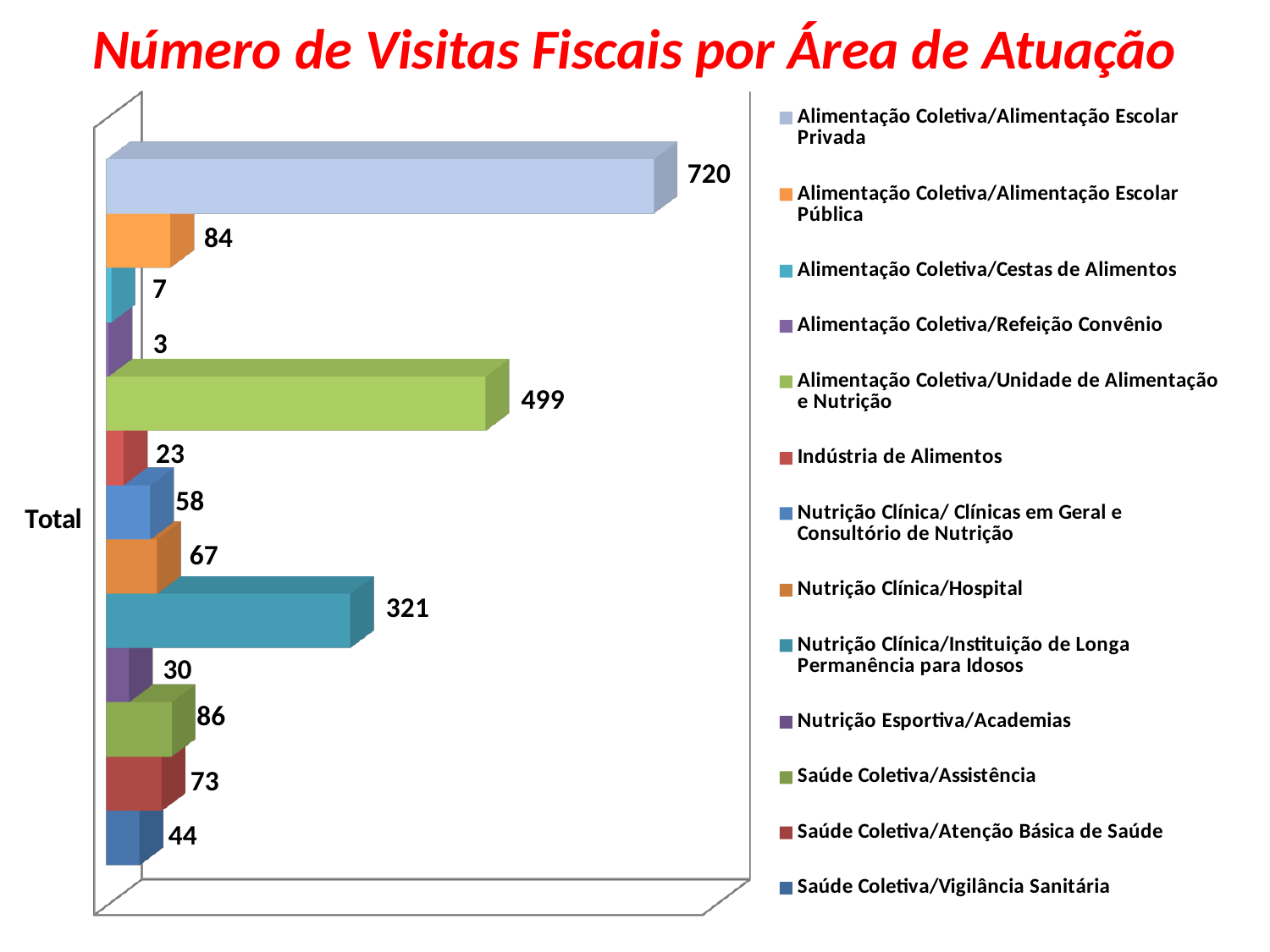
How many series does the legend list? 13 What is the difference between the values for Alimentação Coletiva/Alimentação Escolar Privada and Alimentação Coletiva/Unidade de Alimentação e Nutrição? 221 What is the value for Alimentação Coletiva/Unidade de Alimentação e Nutrição? 499 What is the value for Alimentação Coletiva/Alimentação Escolar Privada? 720 What is the value for Saúde Coletiva/Vigilância Sanitária? 44 Which is larger, the value for Saúde Coletiva/Assistência or the value for Saúde Coletiva/Atenção Básica de Saúde? Saúde Coletiva/Assistência Which series has the lowest value? Alimentação Coletiva/Refeição Convênio What kind of chart is shown on the slide? Bar chart What is the value for Nutrição Clínica/Instituição de Longa Permanência para Idosos? 321 What is the title of the chart? Número de Visitas Fiscais por Área de Atuação What is the difference between the values for Nutrição Clínica/Hospital and Nutrição Clínica/ Clínicas em Geral e Consultório de Nutrição? 9 Which series has the highest value? Alimentação Coletiva/Alimentação Escolar Privada